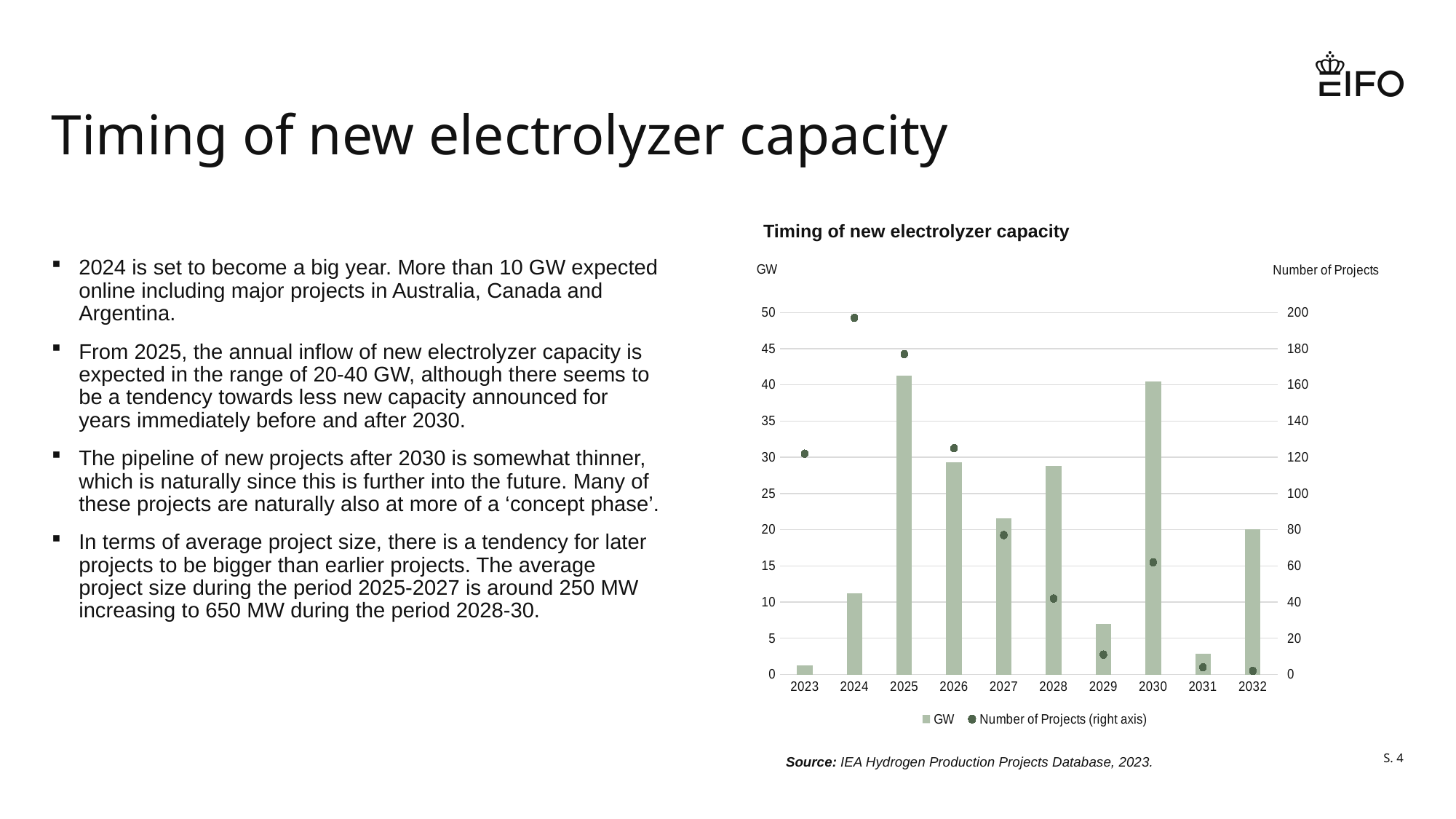
What is the label of the right-hand axis of the chart? Number of Projects What kind of chart is shown on the slide? bar chart (with a dot series on a secondary axis) Is the number of projects for 2028 greater or less than 60? less Which year has the larger GW bar, 2025 or 2026? 2025 What is the title of the chart? Timing of new electrolyzer capacity Which year has the lowest GW bar? 2023 Which year has the highest number of projects? 2024 Is the GW value for 2024 greater or less than 10? greater How many years are shown on the x axis of the chart? 10 Is the GW value for 2029 greater or less than 10? less How many series does the chart legend list? 2 Does the number of projects rise or fall from 2024 to 2029? fall